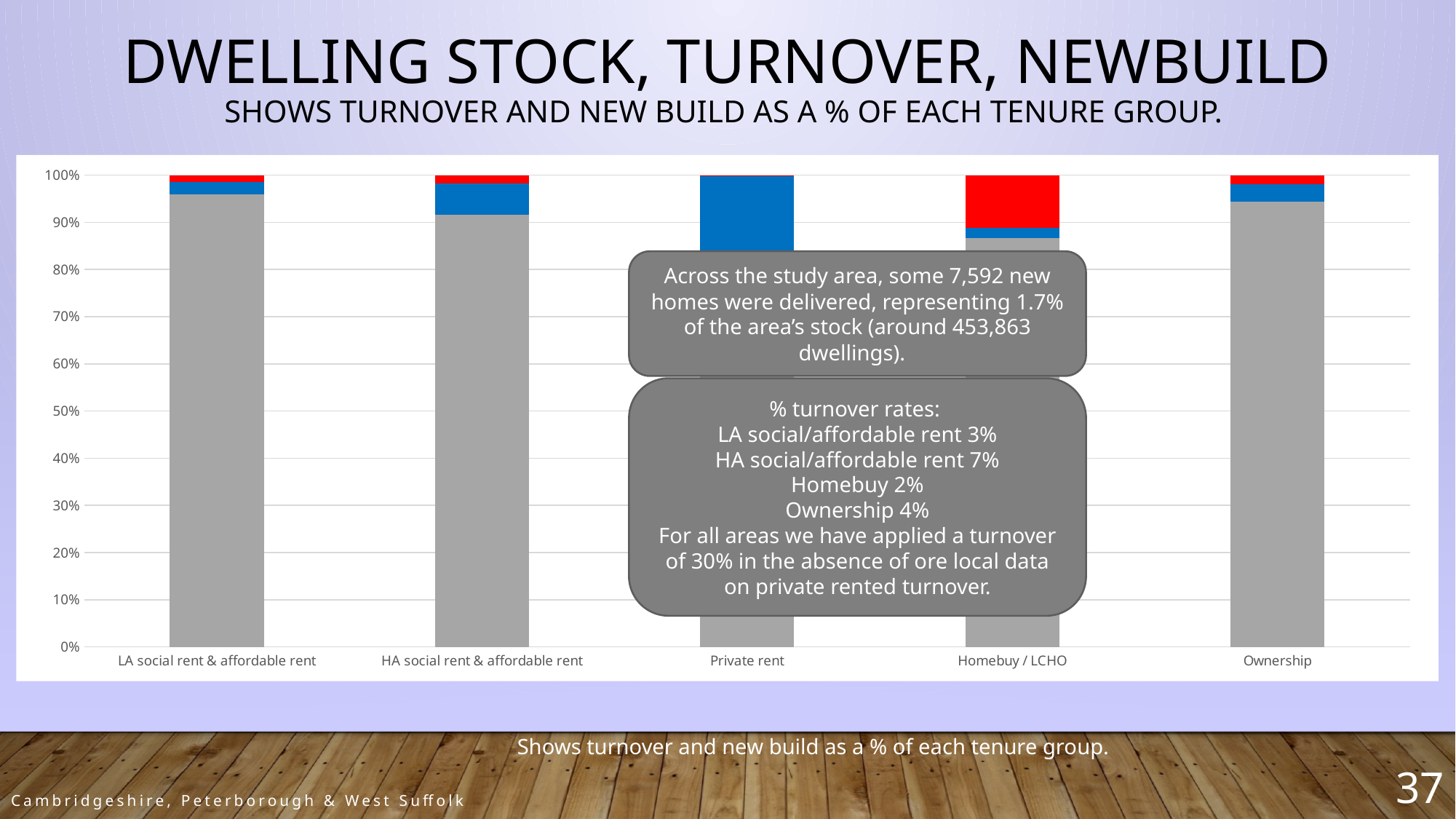
What colour is the bottom segment of each stacked bar? grey What is the highest value shown on the y axis of the chart? 100% Is the red segment larger for Homebuy / LCHO or for Ownership? Homebuy / LCHO What kind of chart is shown on the slide? bar chart How many tenure group categories are shown on the x axis of the chart? 5 Is the top of the grey segment for Ownership greater or less than 80%? greater Which category has the largest red segment? Homebuy / LCHO Is the top of the grey segment for LA social rent & affordable rent greater or less than 90%? greater Is the top of the grey segment for HA social rent & affordable rent greater or less than 80%? greater Is the blue segment larger for HA social rent & affordable rent or for LA social rent & affordable rent? HA social rent & affordable rent Which category has the largest blue segment? Private rent